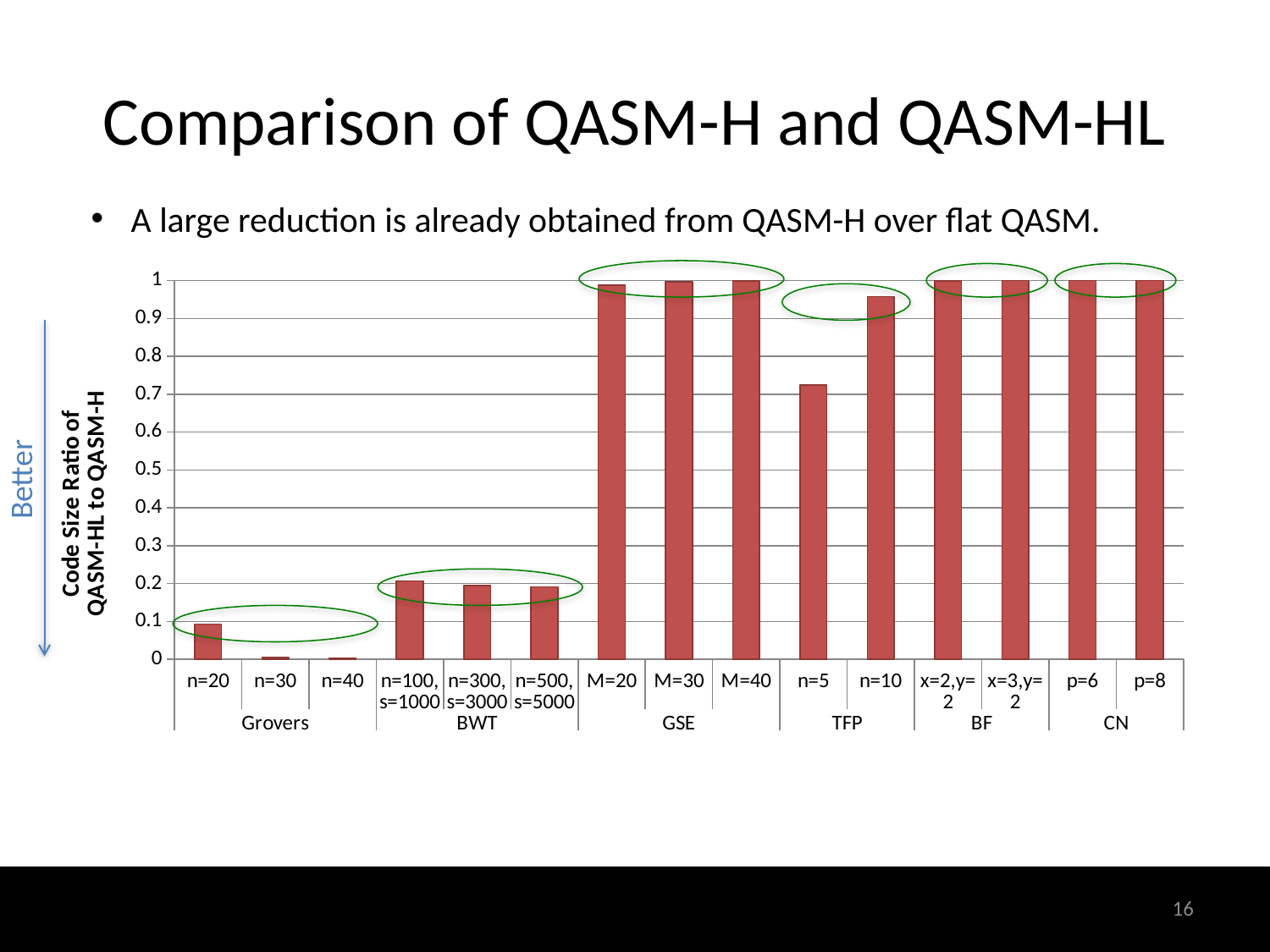
Is the value for TFP n=5 greater or less than 0.8? less What kind of chart is shown on the slide? bar chart Which is larger, the value for TFP n=5 or the value for TFP n=10? TFP n=10 What is the title of the y axis? Code Size Ratio of QASM-HL to QASM-H Is the value for Grovers n=20 greater or less than 0.2? less Is the value for TFP n=10 greater or less than 0.9? greater How many bars are plotted in the chart? 15 Which group has the lowest code size ratios overall: Grovers, BWT, or GSE? Grovers How many algorithm groups (Grovers, BWT, etc.) are labelled along the x axis? 6 Which is larger, the value for Grovers n=20 or the value for BWT n=300, s=3000? BWT n=300, s=3000